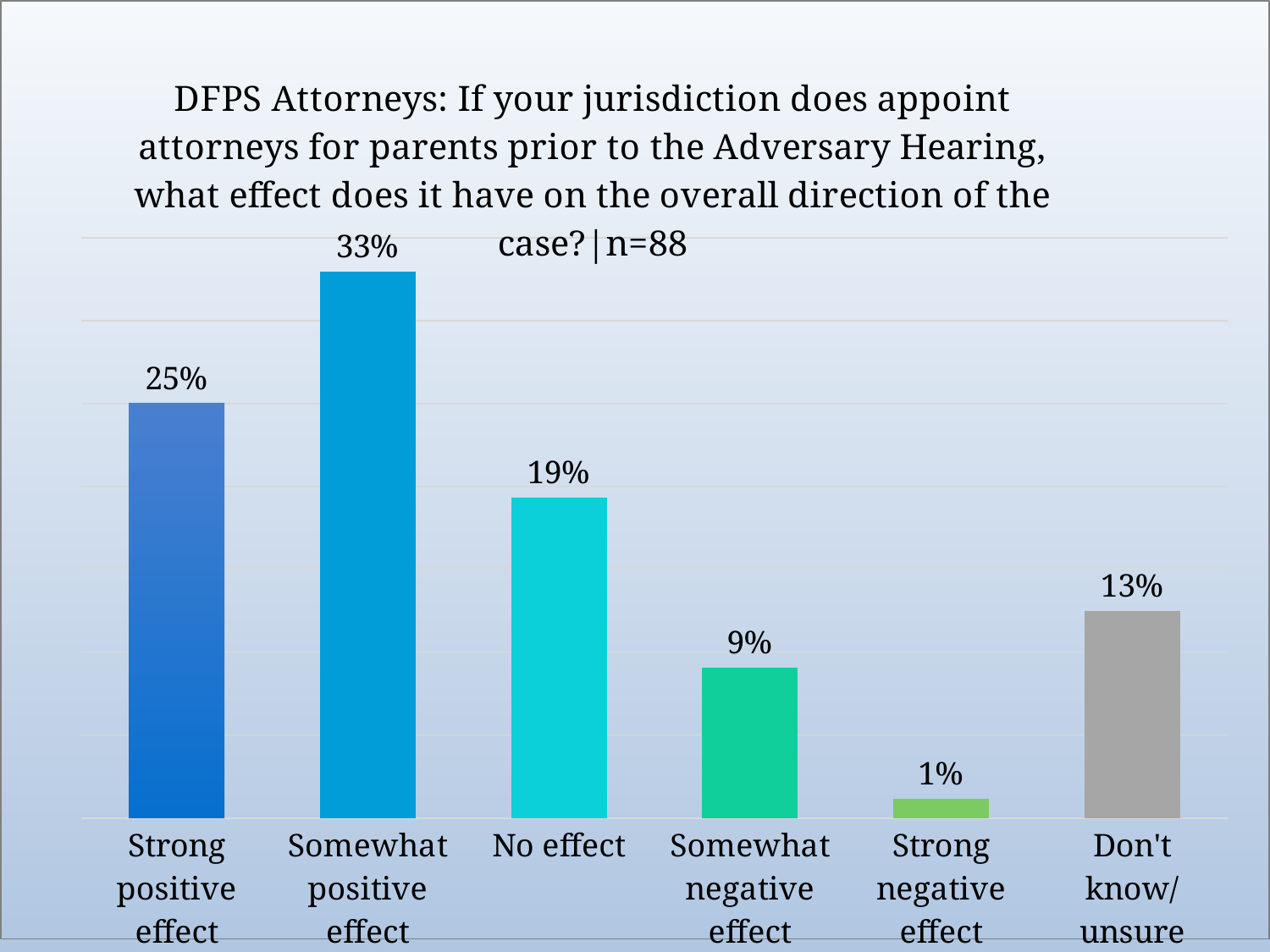
What percentage of DFPS attorneys reported a strong positive effect? 25% How many response categories are shown in the chart? 6 What percentage of DFPS attorneys reported a somewhat positive effect? 33% What is the difference in percentage points between 'Somewhat negative effect' and 'Strong negative effect'? 8 What kind of chart is shown on the slide? Bar chart What is the sample size (n) stated in the chart title? 88 Which response category has the lowest percentage? Strong negative effect Which is larger: the percentage for 'No effect' or for 'Don't know/unsure'? No effect What percentage of DFPS attorneys answered 'Don't know/unsure'? 13% What is the difference in percentage points between 'Somewhat positive effect' and 'Strong positive effect'? 8 Which response category has the highest percentage? Somewhat positive effect What percentage of DFPS attorneys reported no effect? 19%